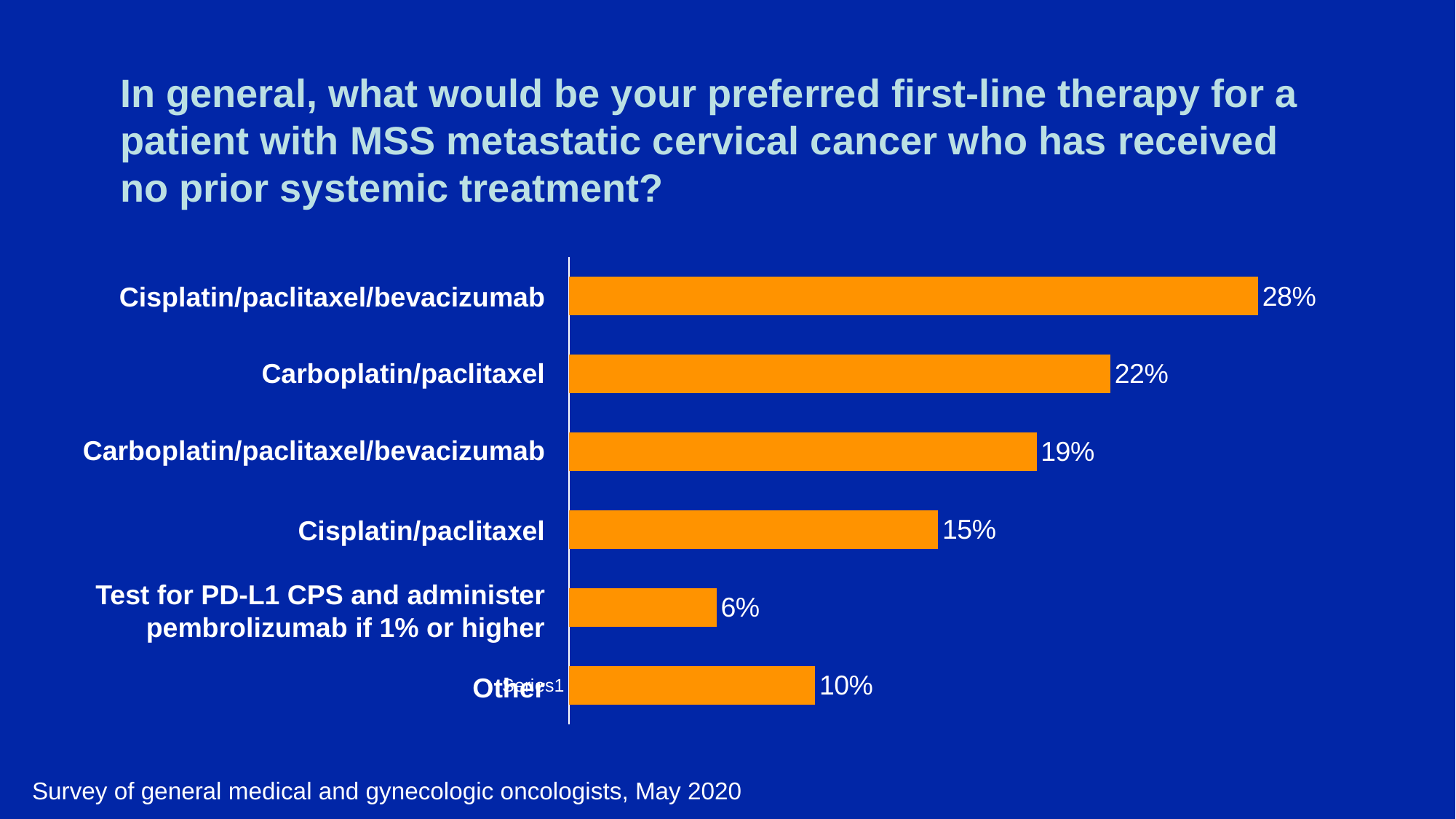
Which option has the lowest percentage? Test for PD-L1 CPS and administer pembrolizumab if 1% or higher What kind of chart is shown on the slide? Bar chart What percentage of respondents chose Cisplatin/paclitaxel/bevacizumab? 28% What colour are the bars in the chart? Orange How many options are shown in the chart? 6 What percentage is shown for Test for PD-L1 CPS and administer pembrolizumab if 1% or higher? 6% Which option has the highest percentage? Cisplatin/paclitaxel/bevacizumab Which has a larger value, Cisplatin/paclitaxel or Other? Cisplatin/paclitaxel What is the difference between the values for Cisplatin/paclitaxel/bevacizumab and Carboplatin/paclitaxel? 6% What is the value shown for Carboplatin/paclitaxel? 22% What is the difference between the values for Carboplatin/paclitaxel/bevacizumab and Cisplatin/paclitaxel? 4% What is the value for Other? 10%